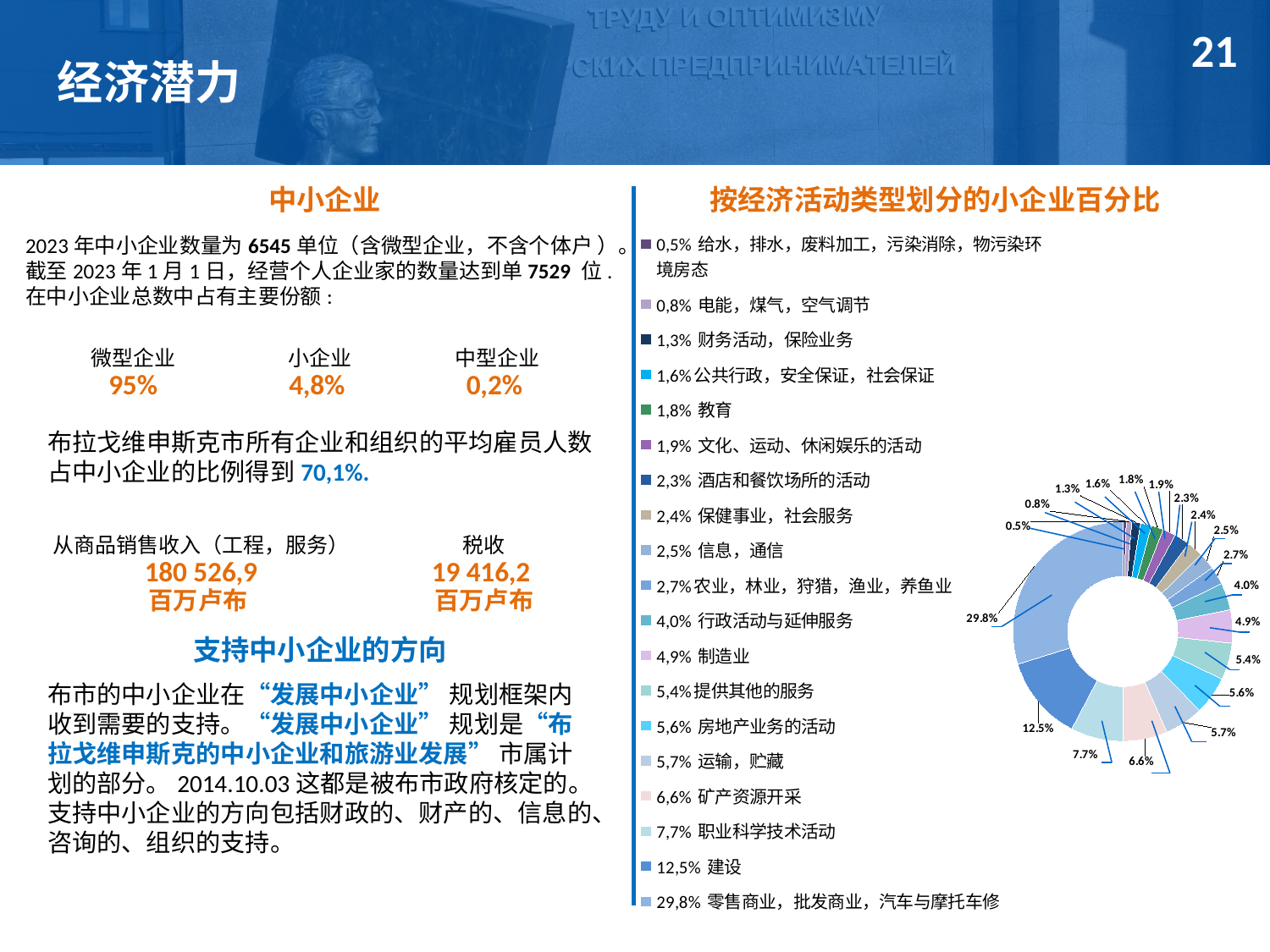
What kind of chart is shown on the slide under the title 按经济活动类型划分的小企业百分比? Doughnut (pie) chart What is the title of the chart on the right side of the slide? 按经济活动类型划分的小企业百分比 In the chart 按经济活动类型划分的小企业百分比, how many percentage points larger is the share of 零售商业，批发商业，汽车与摩托车修 than that of 建设? 17.3 percentage points In the chart 按经济活动类型划分的小企业百分比, which category has the largest share? 零售商业，批发商业，汽车与摩托车修 In the chart 按经济活动类型划分的小企业百分比, which has the larger share: 矿产资源开采 or 运输，贮藏? 矿产资源开采 In the chart 按经济活动类型划分的小企业百分比, what is the share for 行政活动与延伸服务? 4.0% How many categories are shown in the chart 按经济活动类型划分的小企业百分比? 19 In the chart 按经济活动类型划分的小企业百分比, what is the share for 制造业? 4.9% In the chart 按经济活动类型划分的小企业百分比, how many percentage points larger is the share of 建设 than that of 职业科学技术活动? 4.8 percentage points In the chart 按经济活动类型划分的小企业百分比, which category has the smallest share? 给水，排水，废料加工，污染消除，物污染环境房态 In the chart 按经济活动类型划分的小企业百分比, what is the share for 建设? 12.5% In the chart 按经济活动类型划分的小企业百分比, what is the share for 教育? 1.8%